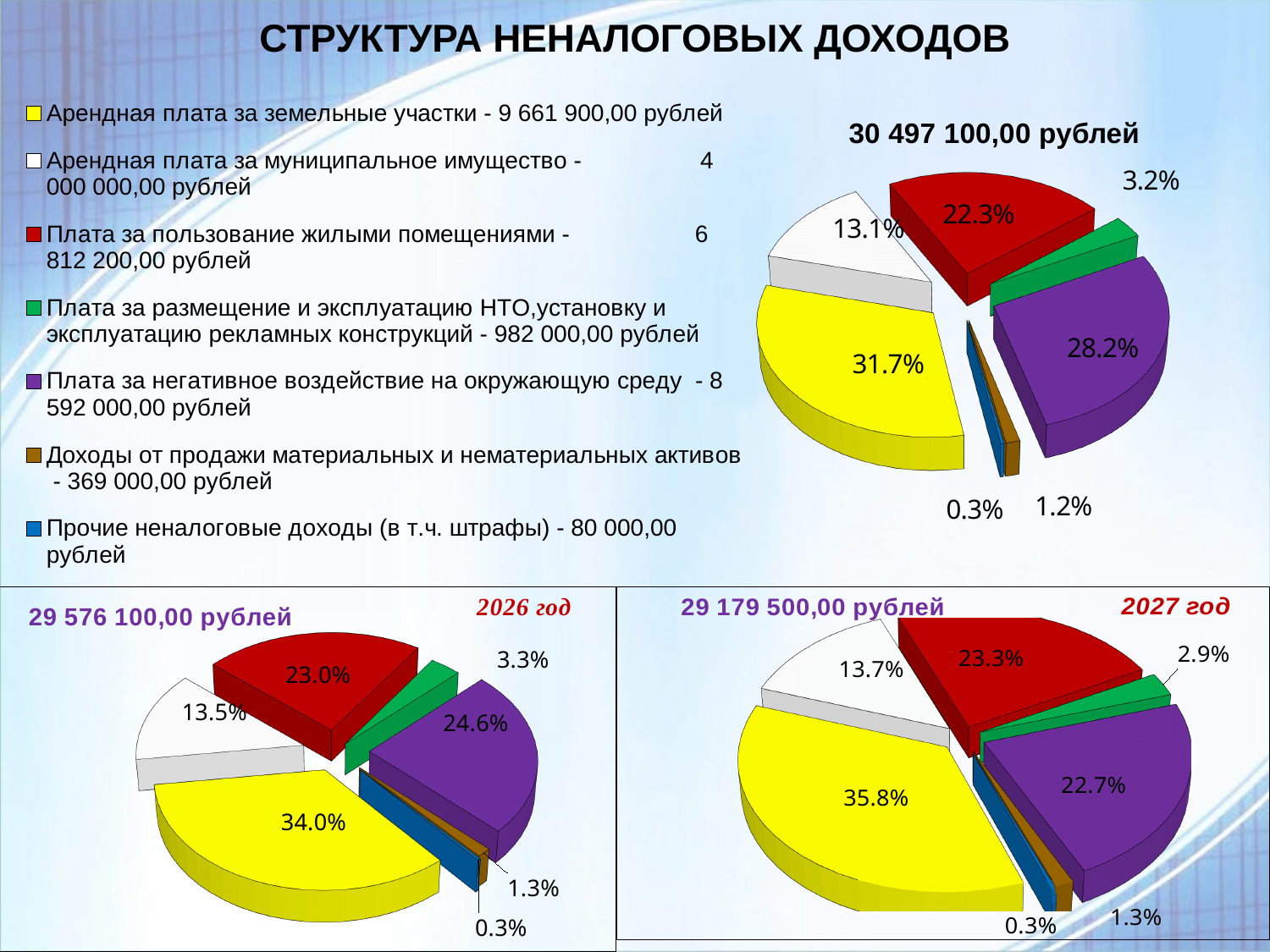
What is the difference between the yellow slice share in the 2027 год chart and in the 2026 год chart? 1.8% In the 2027 год pie chart, what share is shown for the white slice (Арендная плата за муниципальное имущество)? 13.7% In the 2027 год pie chart, which is larger: the red slice (Плата за пользование жилыми помещениями) or the purple slice (Плата за негативное воздействие на окружающую среду)? Red slice (23.3%) In the top-right pie chart (30 497 100,00 рублей), what share is shown for the purple slice (Плата за негативное воздействие на окружающую среду)? 28.2% In the 2026 год pie chart, what share is shown for the red slice (Плата за пользование жилыми помещениями)? 23.0% What type of charts are shown on the slide? Pie charts In the top-right pie chart (30 497 100,00 рублей), which slice is the largest? Арендная плата за земельные участки (31.7%) How many categories does the legend list? 7 In the 2026 год pie chart, which slice is the smallest? Прочие неналоговые доходы (0.3%) How many pie charts are on the slide? 3 What total amount is shown above the 2027 год pie chart? 29 179 500,00 рублей